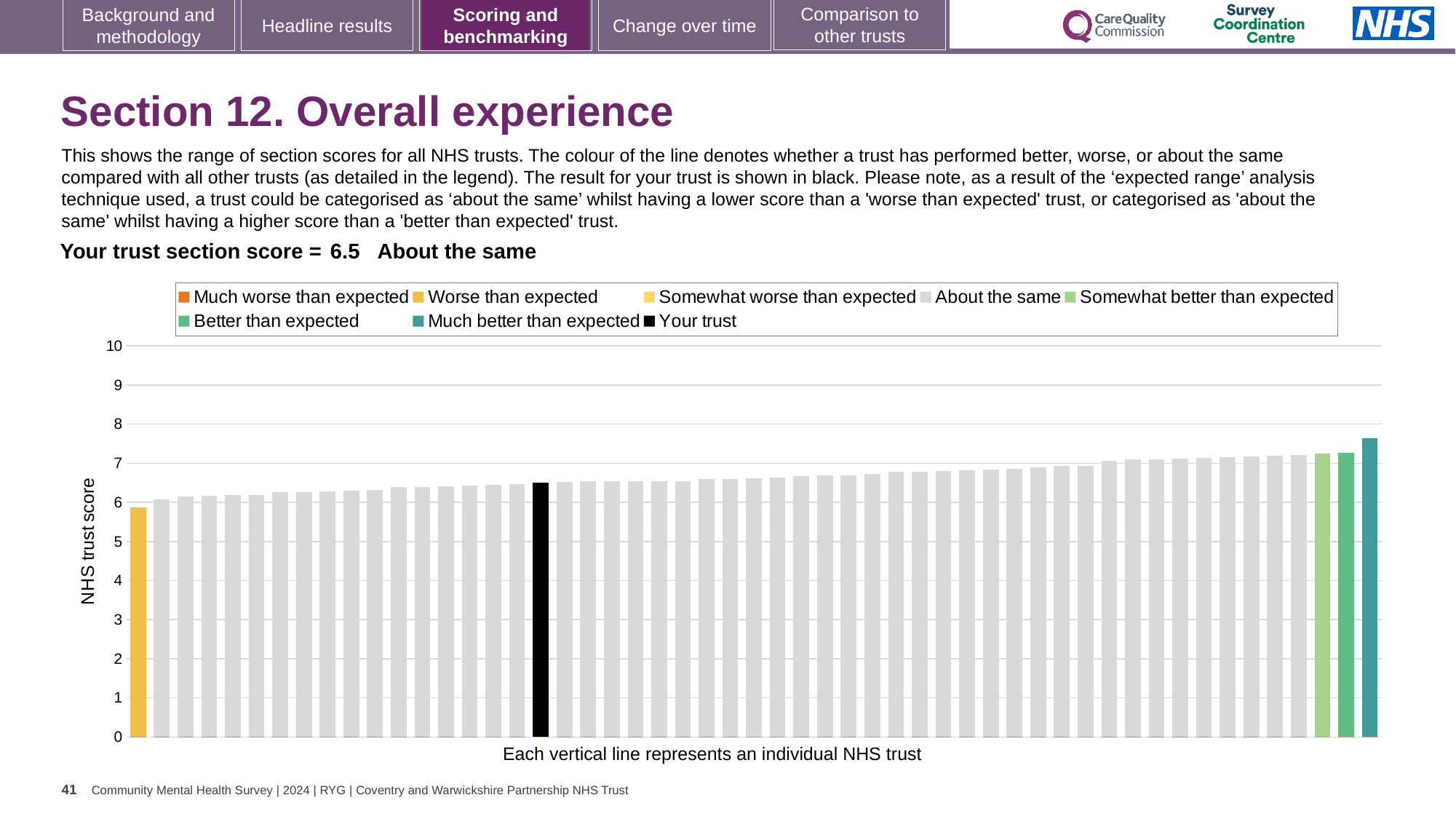
What kind of chart is shown on the slide? bar chart Is the value of the yellow 'Worse than expected' bar greater or less than 7? less Which legend category does the lowest bar on the chart belong to? Worse than expected What is the section score for your trust? 6.5 What is the label on the vertical axis of the chart? NHS trust score Which is larger: the 'Your trust' bar or the 'Worse than expected' bar? Your trust Which legend category does the highest bar on the chart belong to? Much better than expected Which benchmarking category is your trust placed in for Section 12? About the same Is the value of the teal 'Much better than expected' bar greater or less than 7? greater How many entries does the chart legend list? 8 Is the value of the black 'Your trust' bar greater or less than 7? less Do the bar values rise or fall from left to right along the x axis? rise